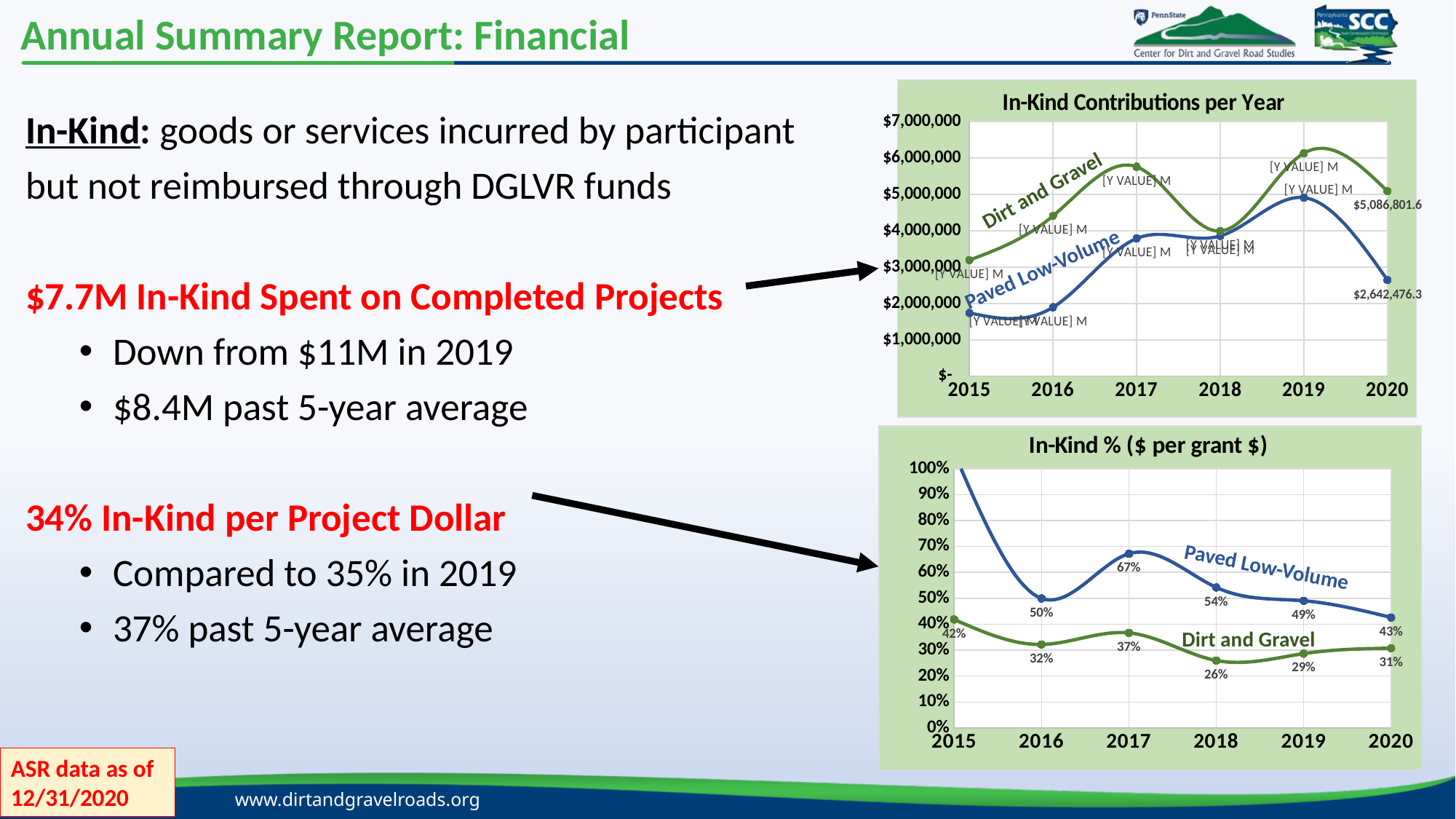
In the 'In-Kind % ($ per grant $)' chart, does the Paved Low-Volume series rise or fall from 2017 to 2020? Fall In the 'In-Kind Contributions per Year' chart, what is the Dirt and Gravel value for 2020? $5,086,801.6 In the 'In-Kind % ($ per grant $)' chart, what is the Paved Low-Volume value for 2017? 67% In the 'In-Kind Contributions per Year' chart, which series has the higher value in 2020, Dirt and Gravel or Paved Low-Volume? Dirt and Gravel In the 'In-Kind Contributions per Year' chart, what is the Paved Low-Volume value for 2020? $2,642,476.3 In the 'In-Kind Contributions per Year' chart, what is the difference between the Dirt and Gravel and Paved Low-Volume values in 2020? $2,444,325.3 In the 'In-Kind Contributions per Year' chart, how many years are shown on the x axis? 6 In the 'In-Kind % ($ per grant $)' chart, what is the Dirt and Gravel value for 2015? 42% In the 'In-Kind % ($ per grant $)' chart, how much higher is the Paved Low-Volume value than the Dirt and Gravel value in 2020? 12 percentage points In the 'In-Kind % ($ per grant $)' chart, in which year is the Dirt and Gravel value lowest? 2018 In the 'In-Kind Contributions per Year' chart, is the Paved Low-Volume value for 2015 greater or less than $2,000,000? less What kind of chart is the 'In-Kind Contributions per Year' chart? Line chart